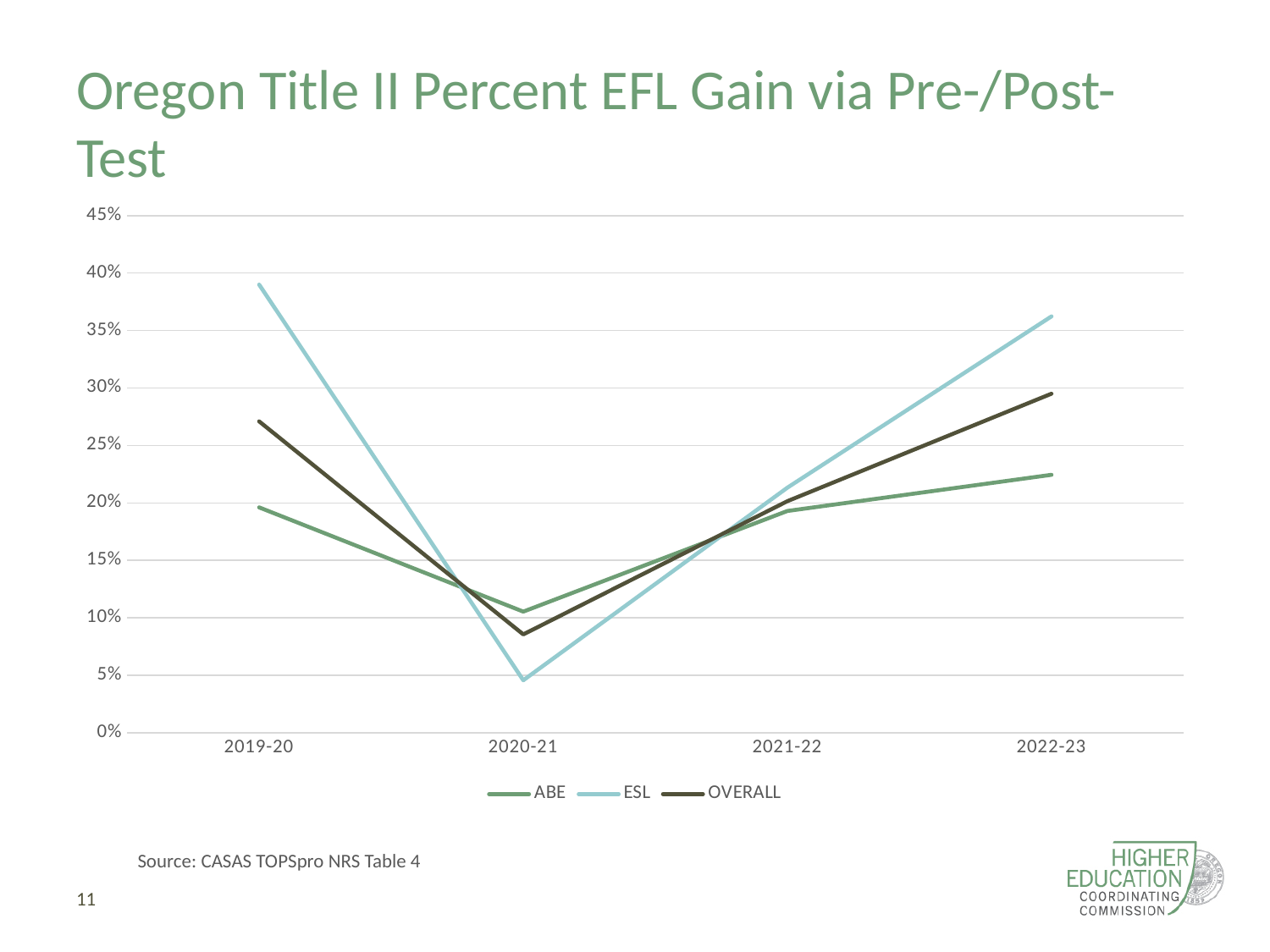
How many program years are plotted along the x axis? 4 How many series does the legend list? 3 In 2019-20, which is larger, the ESL value or the ABE value? ESL In which year is the ESL line at its highest? 2019-20 In which year is the ABE line at its lowest? 2020-21 What kind of chart is shown on the slide? line chart Is the OVERALL value for 2022-23 greater or less than 25%? greater Is the ESL value for 2019-20 greater or less than 35%? greater Is the ESL value for 2020-21 greater or less than 10%? less Which series are listed in the legend? ABE, ESL, OVERALL In which year is the ESL line at its lowest? 2020-21 Does the ABE line rise or fall from 2020-21 to 2022-23? rise